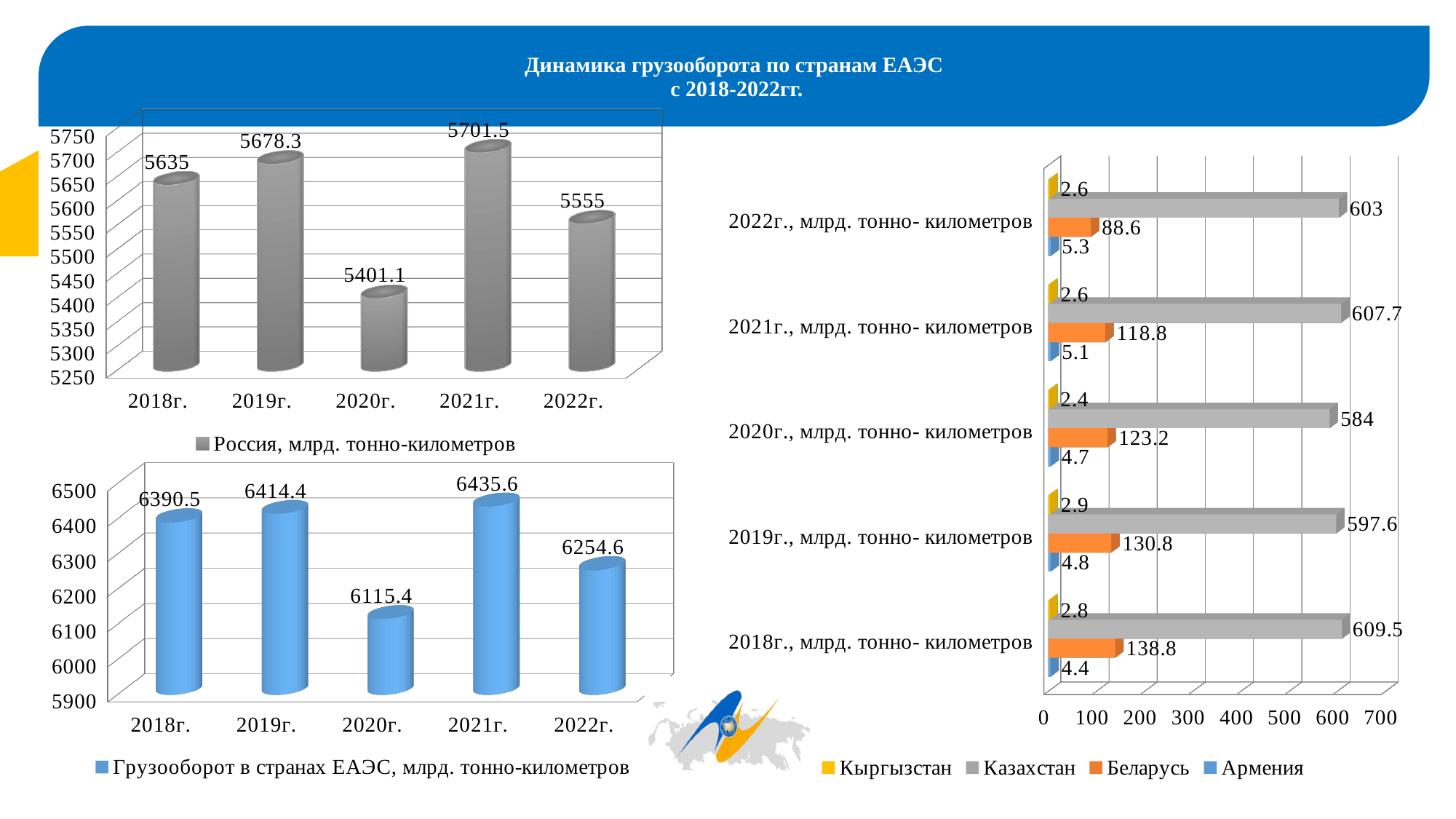
In the bottom-left chart (Грузооборот в странах ЕАЭС), which year has the lowest value? 2020г. What type of chart is the right-hand chart? bar chart In the right-hand chart, is the value for Беларусь in 2022г. larger or smaller than its value in 2018г.? smaller In the right-hand chart, what is the value for Беларусь in 2018г.? 138.8 In the top-left chart (Россия, млрд. тонно-километров), which year has the highest value? 2021г. In the top-left chart (Россия, млрд. тонно-километров), what is the difference between the 2021г. and 2022г. values? 146.5 In the right-hand chart, how many series does the legend list? 4 In the bottom-left chart (Грузооборот в странах ЕАЭС), what is the value for 2022г.? 6254.6 In the top-left chart (Россия, млрд. тонно-километров), what is the value for 2020г.? 5401.1 In the right-hand chart, what is the difference between the Беларусь values for 2019г. and 2020г.? 7.6 In the bottom-left chart (Грузооборот в странах ЕАЭС), how many years are plotted? 5 In the right-hand chart, what is the value for Казахстан in 2021г.? 607.7